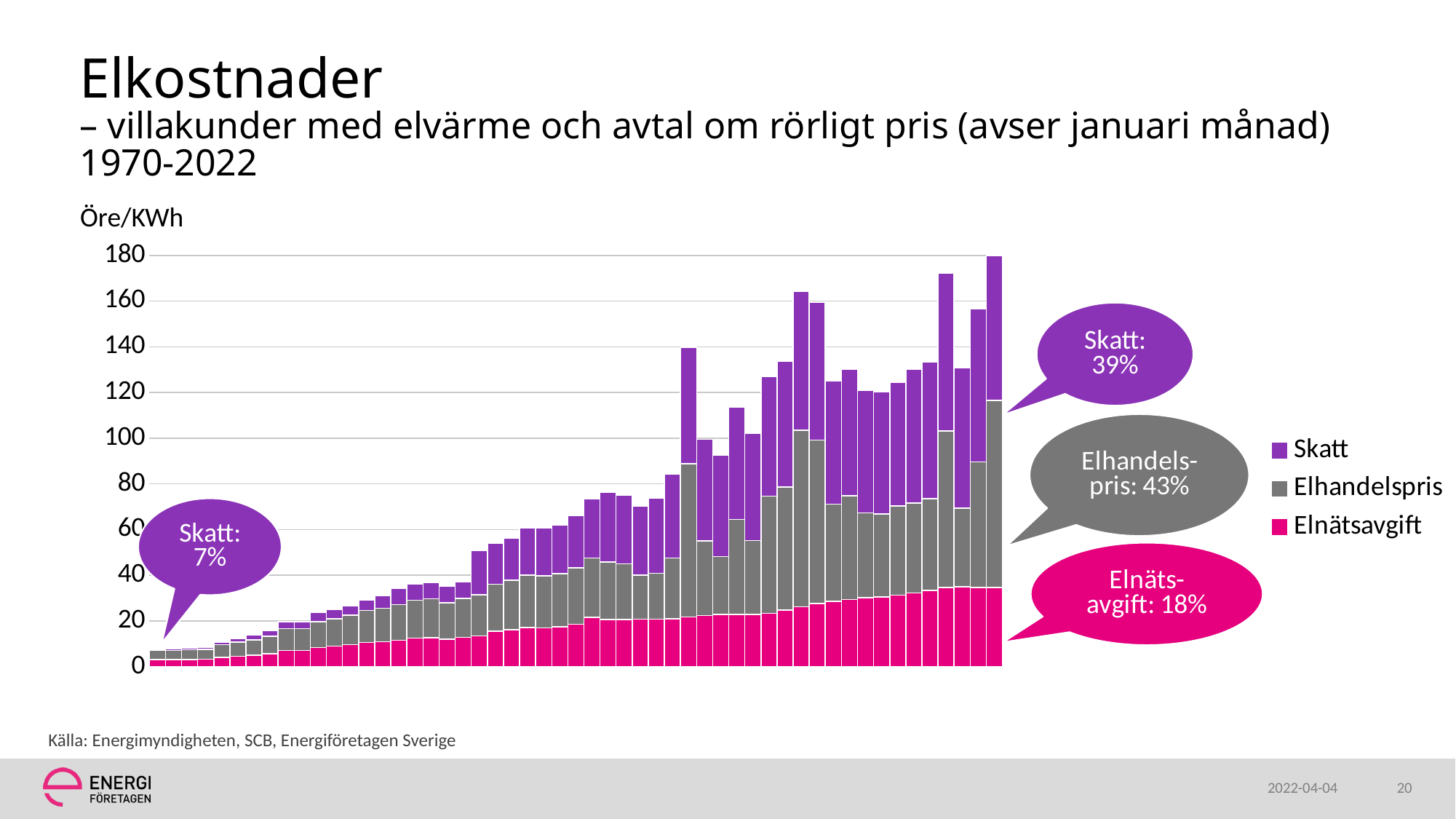
Do the total electricity costs generally rise or fall from left to right across the chart? rise According to the callout, what share of the cost is Skatt in the most recent year? 39% According to the callout, what share of the cost is Elhandelspris in the most recent year? 43% Is the total of the tallest (rightmost) bar greater or less than 160? greater How many series does the legend list? 3 According to the callout at the left of the chart, what share of the cost was Skatt in the early years? 7% What unit is shown on the y axis of the chart? Öre/KWh Which series is plotted at the bottom of each stacked bar? Elnätsavgift Which series are listed in the legend? Skatt, Elhandelspris, Elnätsavgift Is the total of the first (leftmost) bar greater or less than 20? less What kind of chart is shown on the slide? Stacked bar chart According to the callout, what share of the cost is Elnätsavgift in the most recent year? 18%